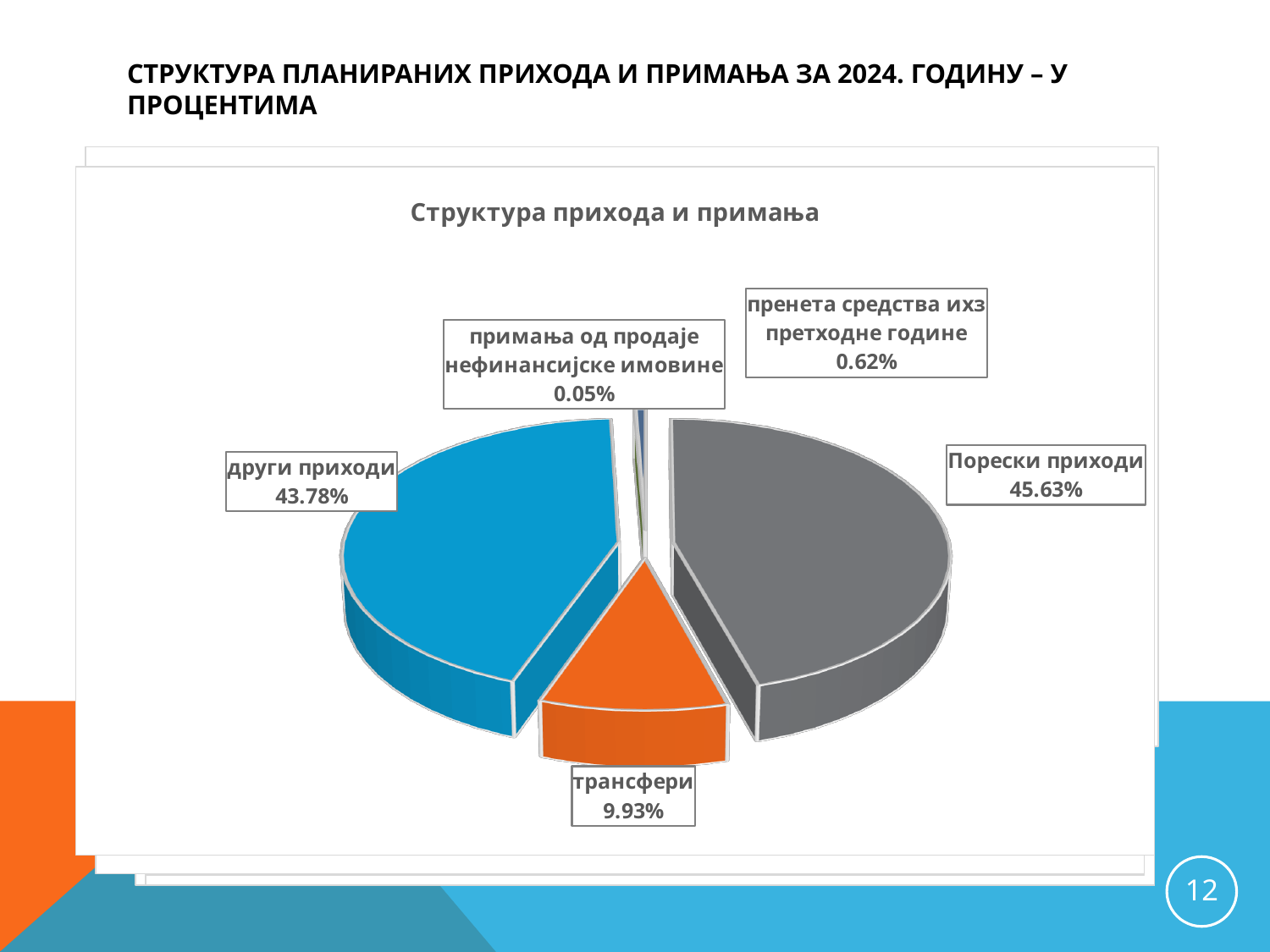
Which is larger, the value for трансфери or the value for пренета средства ихз претходне године? трансфери What is the value shown for примања од продаје нефинансијске имовине? 0.05% How many slices does the pie chart have? 5 What kind of chart is shown on the slide? Pie chart Which category has the largest share of the pie? Порески приходи What is the value shown for пренета средства ихз претходне године? 0.62% What is the title of the chart? Структура прихода и примања Which category has the smallest share of the pie? примања од продаје нефинансијске имовине What is the value shown for трансфери? 9.93% What is the value shown for Порески приходи? 45.63% What is the difference between the values for Порески приходи and други приходи? 1.85% What is the value shown for други приходи? 43.78%